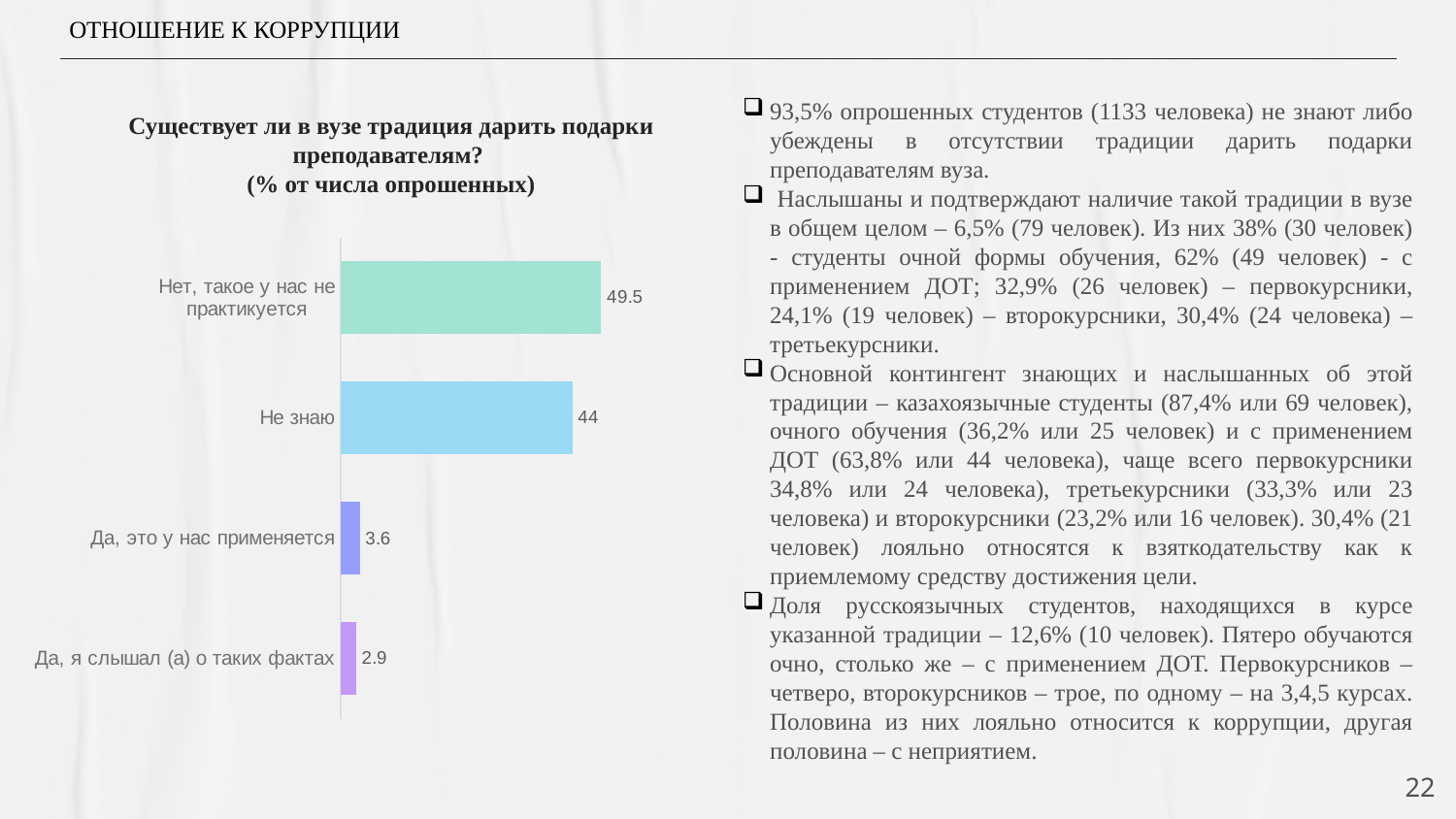
What kind of chart is shown on the slide? Bar chart What is the value for "Да, я слышал (а) о таких фактах"? 2.9 What is the title of the chart? Существует ли в вузе традиция дарить подарки преподавателям? (% от числа опрошенных) What is the value for "Нет, такое у нас не практикуется"? 49.5 What is the difference between the values for "Нет, такое у нас не практикуется" and "Не знаю"? 5.5 Which category has the lowest value? Да, я слышал (а) о таких фактах What is the value for "Да, это у нас применяется"? 3.6 How many categories are shown in the chart? 4 Which is larger: the value for "Не знаю" or the value for "Да, это у нас применяется"? Не знаю What is the difference between the values for "Да, это у нас применяется" and "Да, я слышал (а) о таких фактах"? 0.7 Which category has the highest value? Нет, такое у нас не практикуется What is the value for "Не знаю"? 44